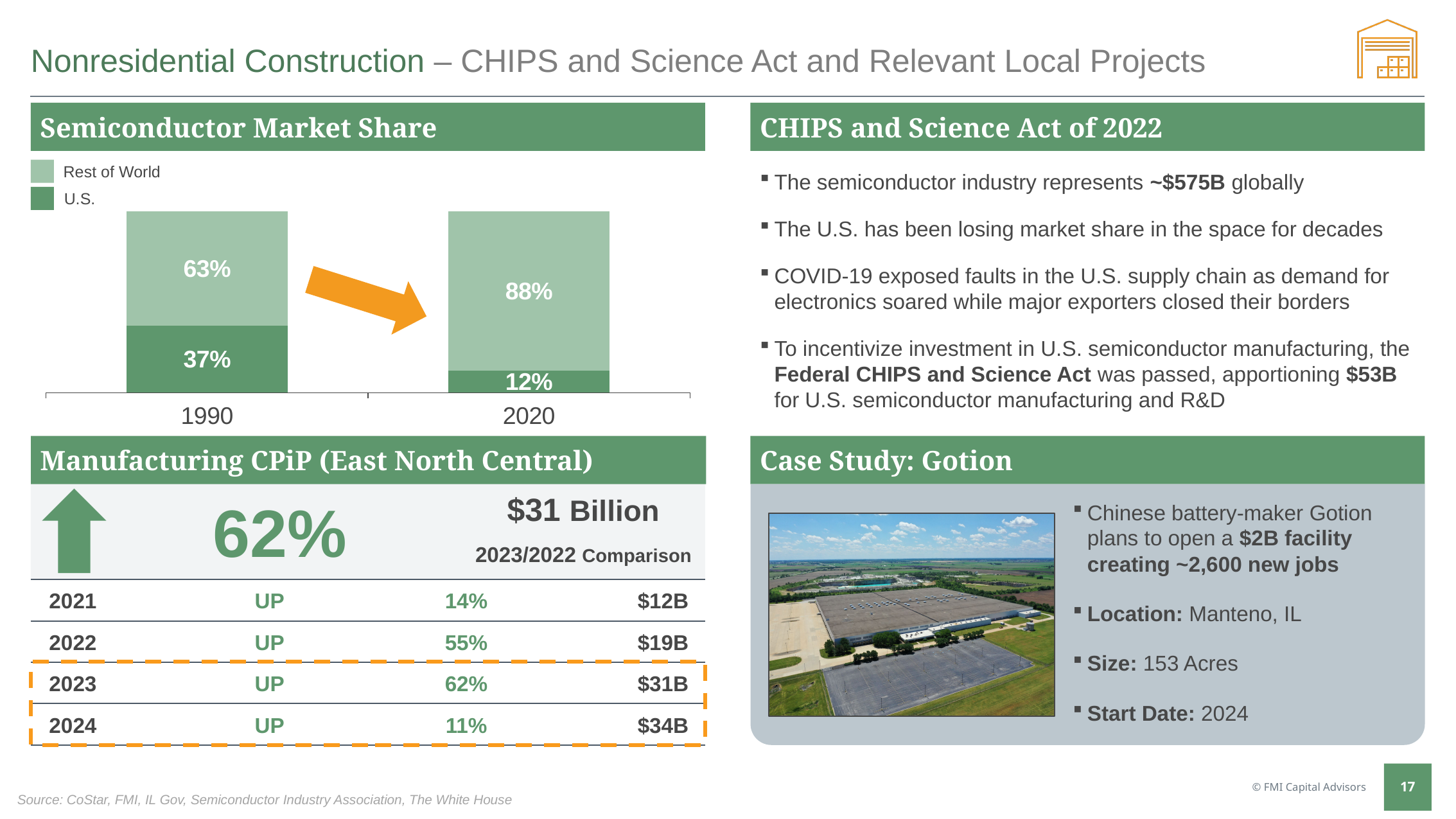
In the Semiconductor Market Share chart, does the U.S. share rise or fall from 1990 to 2020? fall How many years are shown on the x axis of the Semiconductor Market Share chart? 2 In the Semiconductor Market Share chart, which series is shown in the darker green? U.S. In the Semiconductor Market Share chart, what is the U.S. share in 1990? 37% In the Semiconductor Market Share chart, by how many percentage points did the U.S. share fall from 1990 to 2020? 25% What kind of chart is the Semiconductor Market Share chart? stacked bar chart How many series does the legend of the Semiconductor Market Share chart list? 2 In the Semiconductor Market Share chart, what is the difference between the Rest of World share and the U.S. share in 2020? 76% In the Semiconductor Market Share chart, what is the Rest of World share in 2020? 88% In the Semiconductor Market Share chart, which year has the higher U.S. share, 1990 or 2020? 1990 In the Semiconductor Market Share chart, what is the Rest of World share in 1990? 63% In the Semiconductor Market Share chart, what is the U.S. share in 2020? 12%